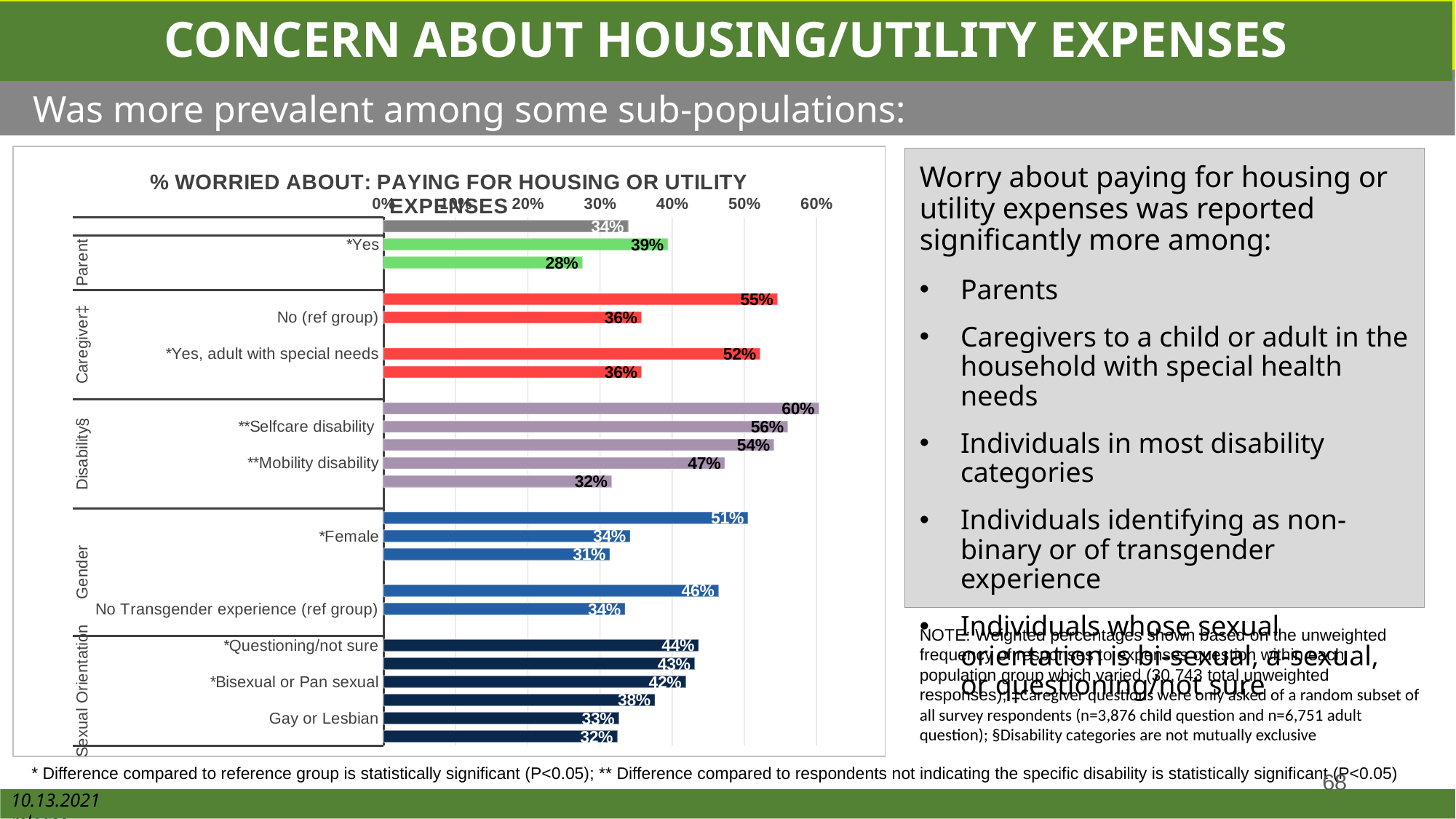
What percentage is shown for '**Mobility disability'? 47% What percentage of parents (*Yes) reported worry about paying for housing or utility expenses? 39% What is the difference between '*Yes, adult with special needs' and 'No (ref group)' in the Caregiver group? 16 percentage points Is the value for '*Female' greater or less than 40%? less What is the value for 'Gay or Lesbian'? 33% What is the difference between the values for '**Selfcare disability' and '**Mobility disability'? 9 percentage points What percentage is shown for '**Selfcare disability'? 56% What is the value for 'No Transgender experience (ref group)'? 34% What kind of chart is shown on the slide? Bar chart What is the value for '*Yes, adult with special needs' in the Caregiver group? 52% How many sub-population groups are labeled along the left side of the chart (e.g., Parent, Gender)? 5 Which has a higher value: '*Questioning/not sure' or '*Bisexual or Pan sexual'? *Questioning/not sure